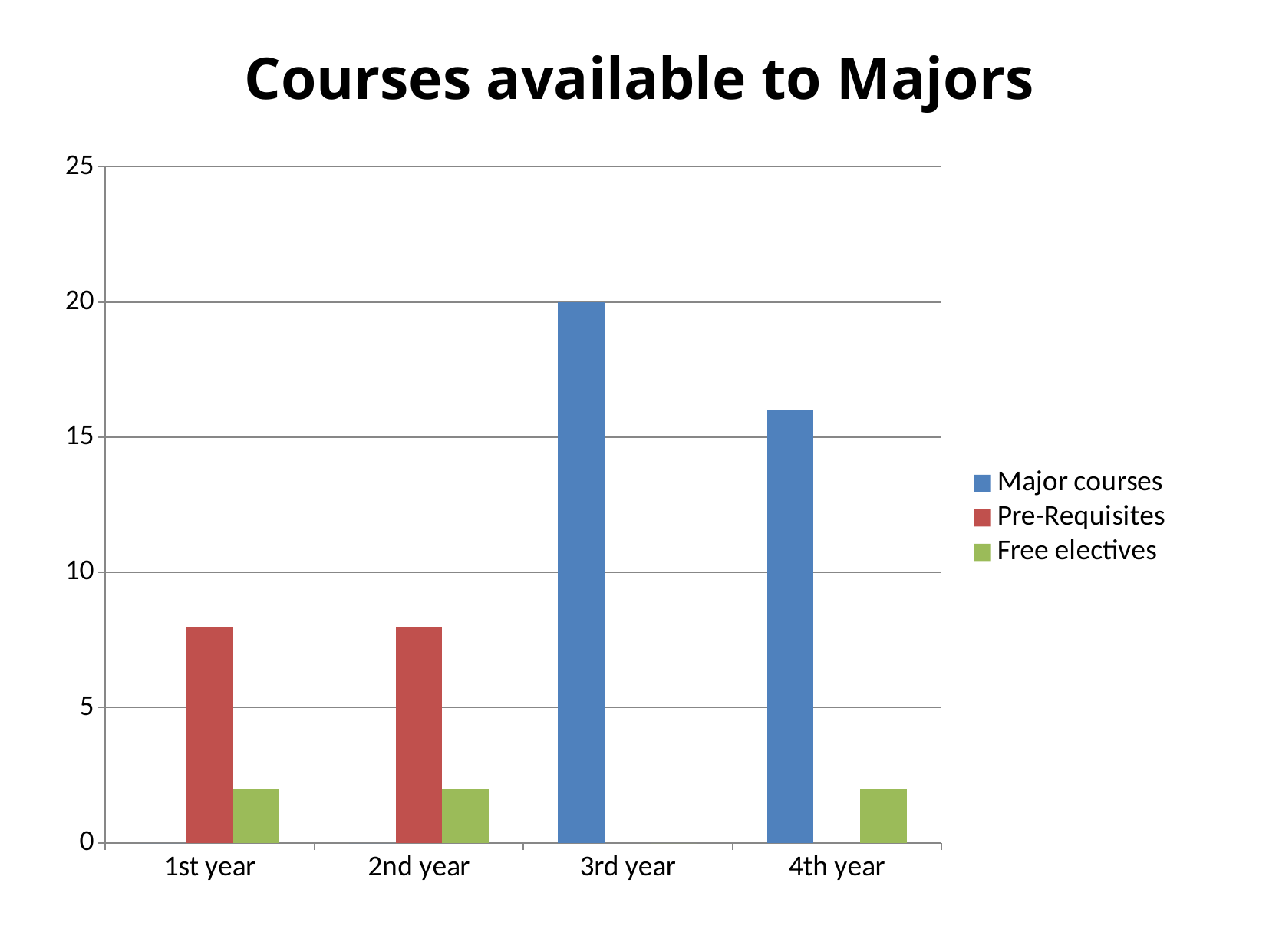
What kind of chart is shown on the slide? bar chart How many year categories are shown on the x axis? 4 Which is larger, Major courses in 3rd year or Major courses in 4th year? Major courses in 3rd year Is the value for Free electives in 2nd year greater or less than 5? less Is the value for Major courses in 4th year greater or less than 15? greater Which is larger in 1st year, Pre-Requisites or Free electives? Pre-Requisites Which colour represents Free electives in the legend? green How many series does the legend list? 3 What is the title of the chart? Courses available to Majors Is the value for Pre-Requisites in 1st year greater or less than 10? less Which year has the highest value for Major courses? 3rd year What is the value for Major courses in 3rd year? 20